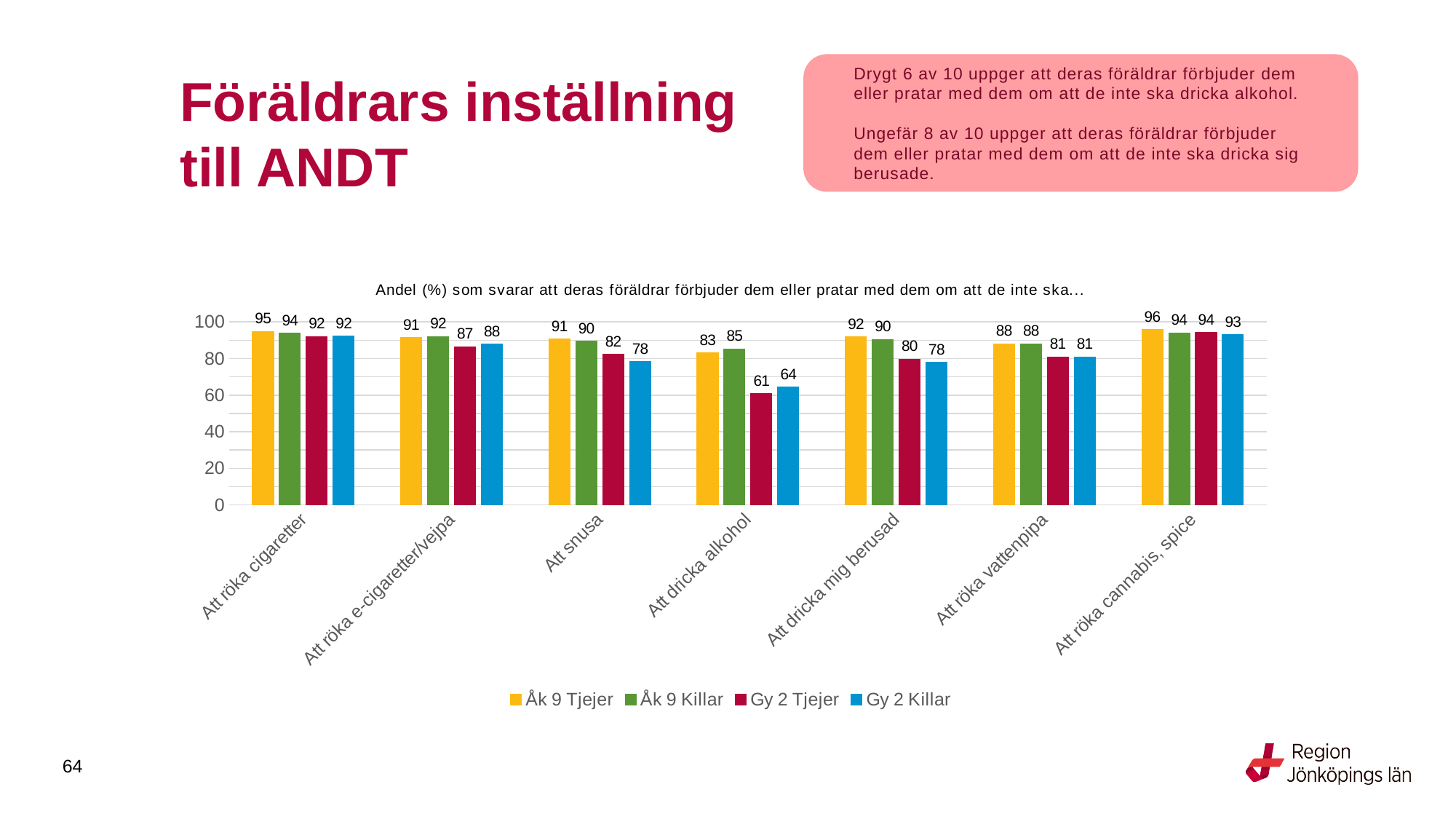
What is the difference between Åk 9 Killar and Gy 2 Tjejer for "Att dricka alkohol"? 24 How many series does the legend list? 4 Which category has the lowest value for Gy 2 Tjejer? Att dricka alkohol What is the value for Åk 9 Tjejer for "Att röka cannabis, spice"? 96 Which series is shown in blue in the legend? Gy 2 Killar What kind of chart is shown on the slide? Bar chart What is the value for Gy 2 Killar for "Att snusa"? 78 For "Att röka e-cigaretter/vejpa", which is larger: Åk 9 Killar or Gy 2 Tjejer? Åk 9 Killar Is the value for Gy 2 Killar for "Att dricka alkohol" greater or less than 80? less Which category has the highest value for Åk 9 Tjejer? Att röka cannabis, spice How many categories are shown on the x axis? 7 What is the value for Gy 2 Tjejer for "Att dricka alkohol"? 61